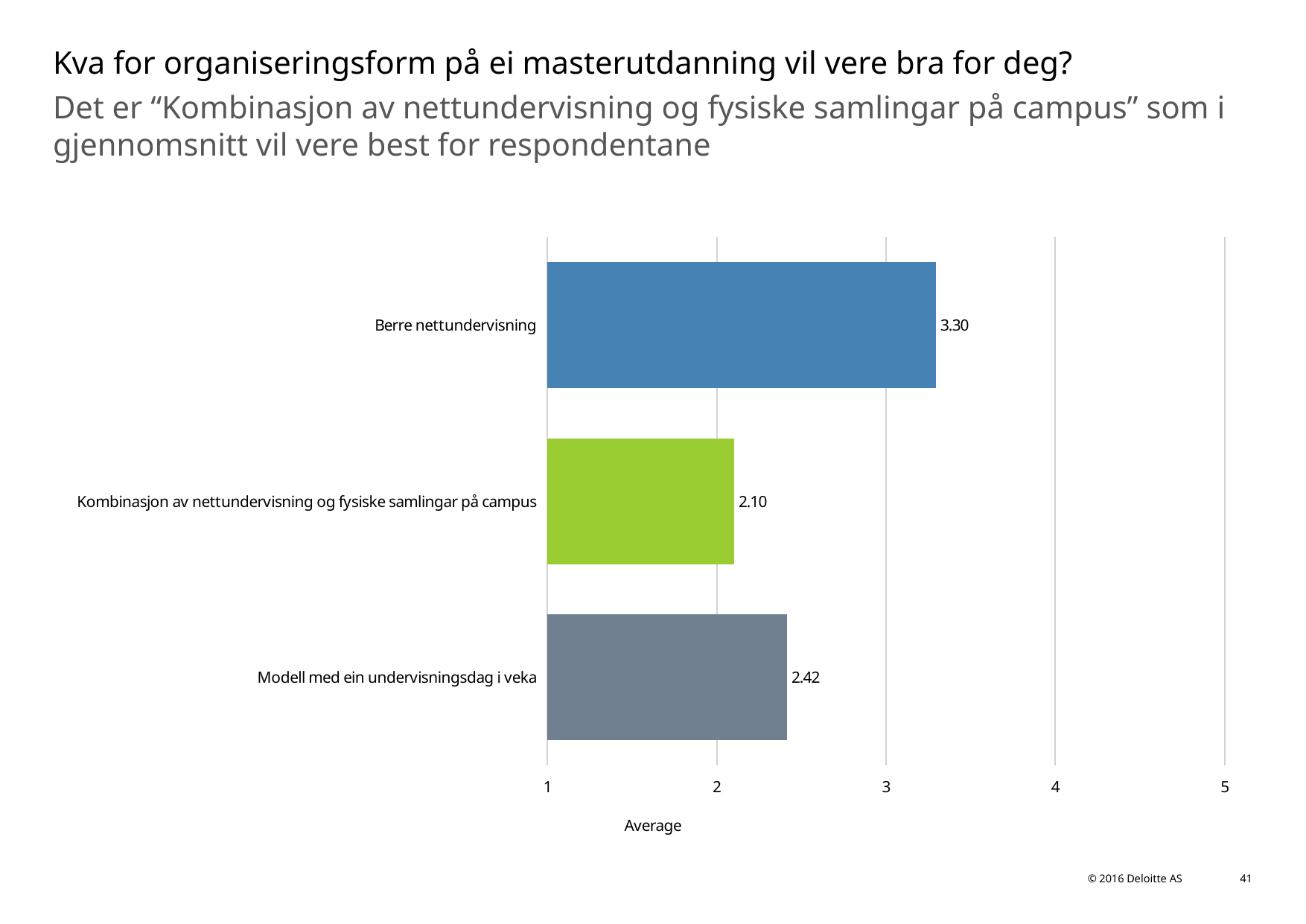
Which category has the lowest average value? Kombinasjon av nettundervisning og fysiske samlingar på campus What is the average value for "Modell med ein undervisningsdag i veka"? 2.42 Which has a larger average value, "Berre nettundervisning" or "Modell med ein undervisningsdag i veka"? Berre nettundervisning Is the value for "Berre nettundervisning" greater or less than 3? greater What is the difference between the average for "Berre nettundervisning" and "Modell med ein undervisningsdag i veka"? 0.88 How many categories are shown in the chart? 3 What is the average value for "Berre nettundervisning"? 3.30 What is the difference between the average for "Modell med ein undervisningsdag i veka" and "Kombinasjon av nettundervisning og fysiske samlingar på campus"? 0.32 Which category has the highest average value? Berre nettundervisning What is the average value for "Kombinasjon av nettundervisning og fysiske samlingar på campus"? 2.10 What kind of chart is shown on the slide? Bar chart What is the label on the horizontal axis of the chart? Average